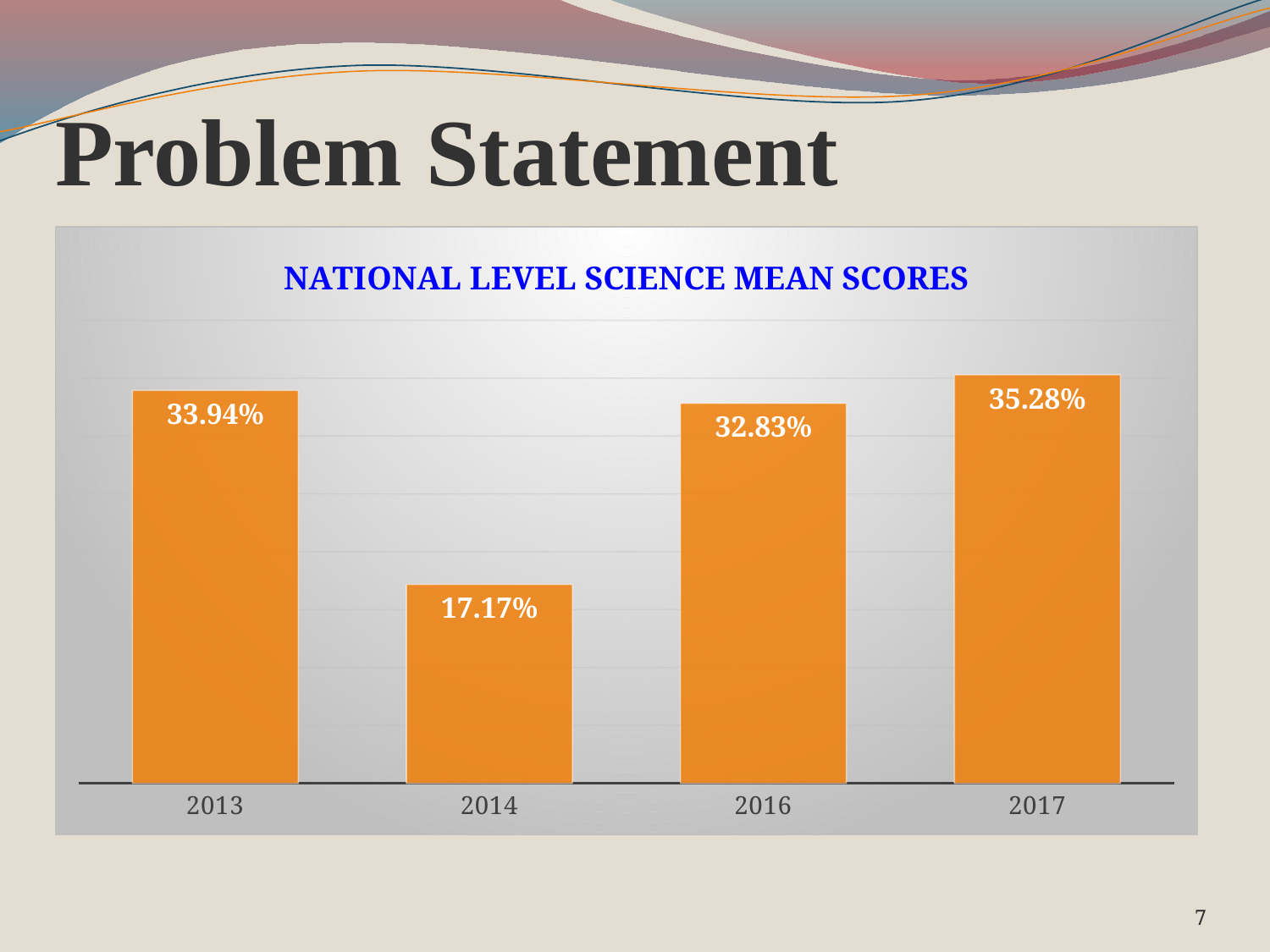
What is the difference between the 2013 and 2016 mean scores? 1.11% How many years are shown on the chart? 4 Which year has the lowest national level science mean score? 2014 What is the national level science mean score for 2017? 35.28% What is the national level science mean score for 2016? 32.83% What is the title of the chart? NATIONAL LEVEL SCIENCE MEAN SCORES What is the difference between the 2017 and 2014 mean scores? 18.11% What is the national level science mean score for 2013? 33.94% What kind of chart is shown on the slide? Bar chart Which year has the highest national level science mean score? 2017 Which year has a higher mean score, 2013 or 2016? 2013 What is the national level science mean score for 2014? 17.17%